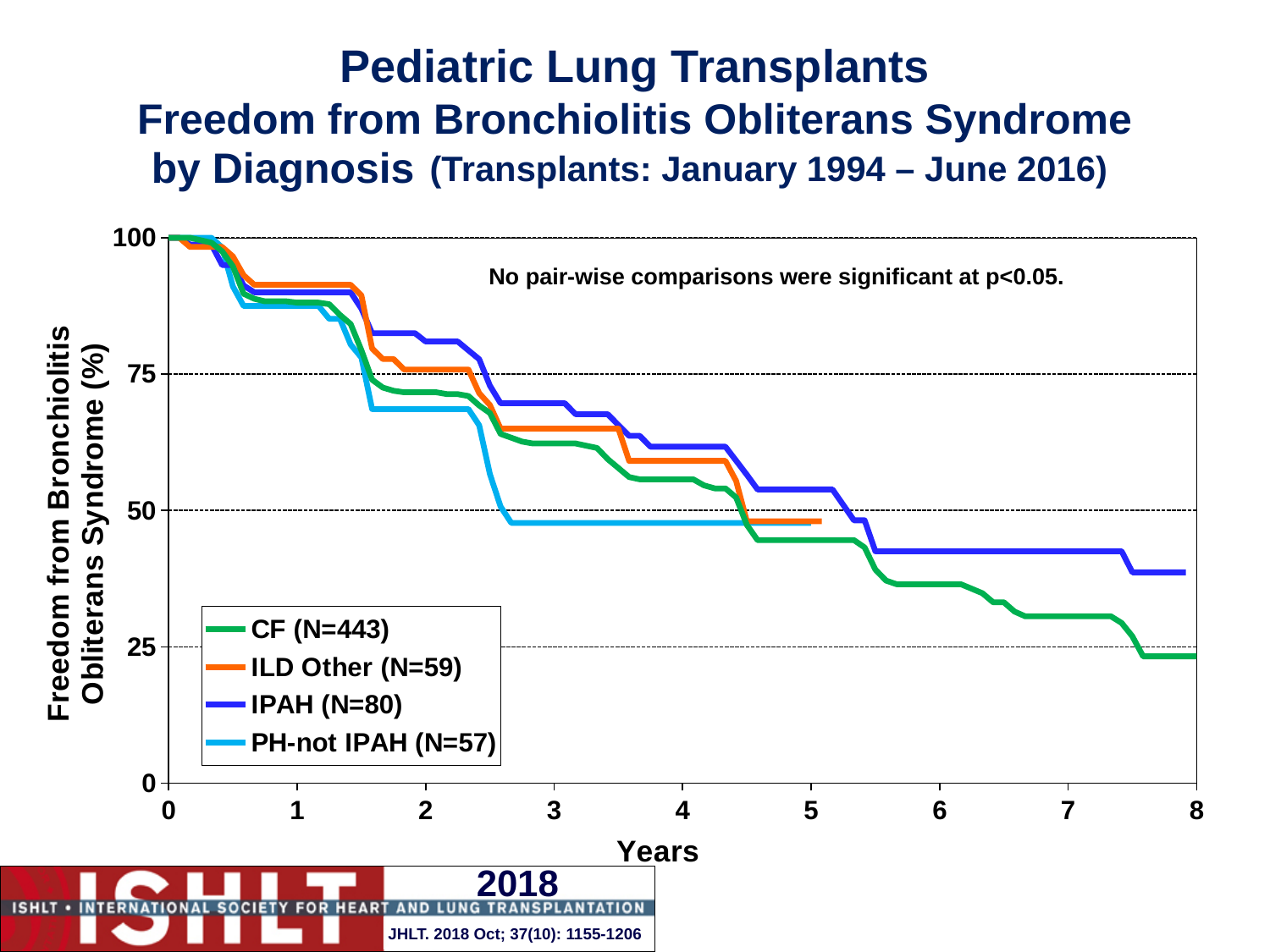
Is the value for CF at 8 years greater or less than 25? less How many series does the legend list? 4 Is the value for PH-not IPAH at 2 years greater or less than 75? less What note is printed inside the chart area about pair-wise comparisons? No pair-wise comparisons were significant at p<0.05. Is the value for ILD Other at 3 years greater or less than 50? greater Do the values for the CF series rise or fall as years increase? fall At 2 years, which series has the higher value, IPAH or PH-not IPAH? IPAH What kind of chart is shown on the slide? line chart Which series has the lowest value at 3 years? PH-not IPAH At 6 years, which series has the higher value, IPAH or CF? IPAH What is the N for the CF group shown in the legend? 443